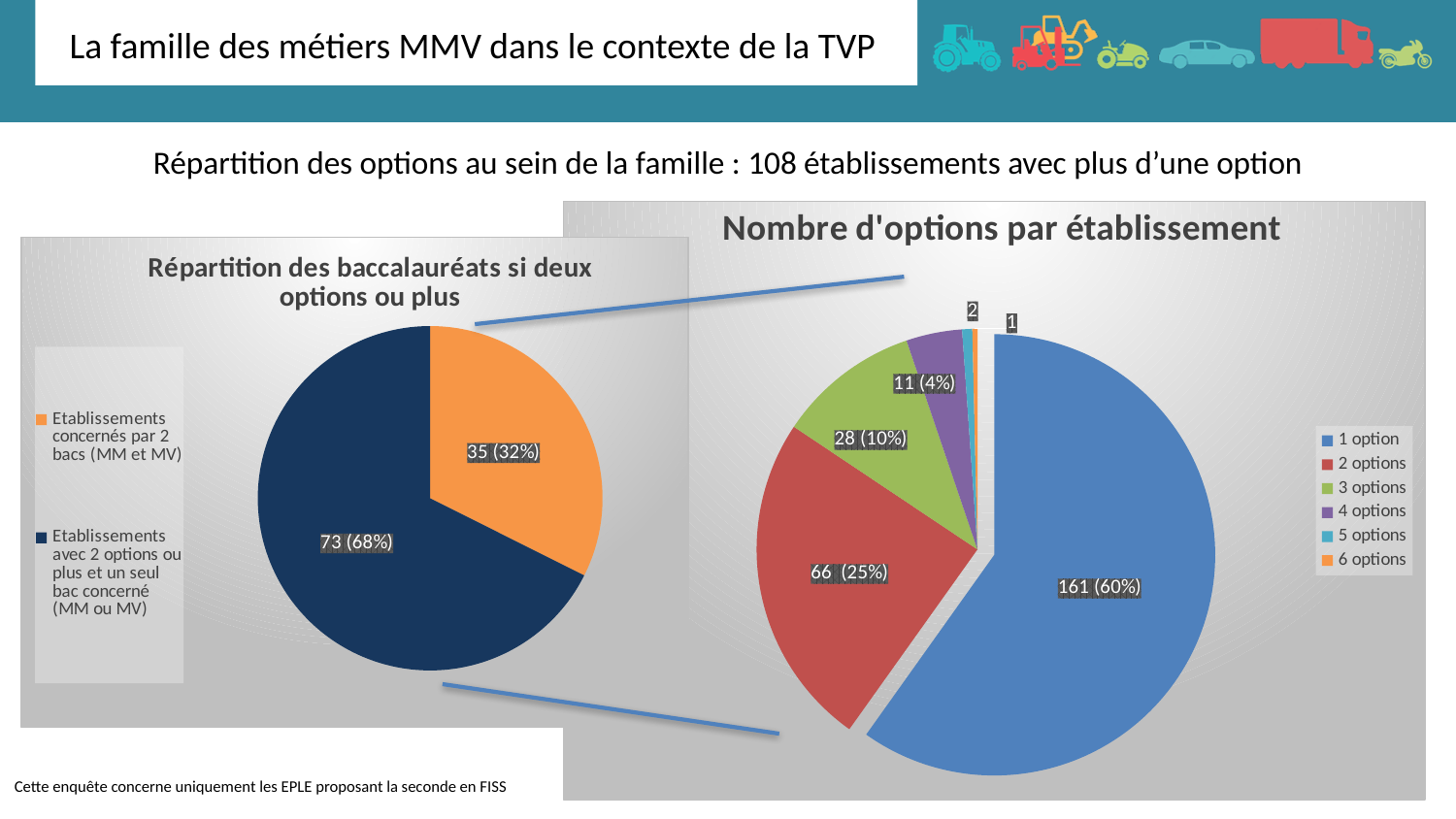
In the chart "Répartition des baccalauréats si deux options ou plus", what colour is the slice for "Etablissements concernés par 2 bacs (MM et MV)"? orange In the chart "Répartition des baccalauréats si deux options ou plus", what is the value for "Etablissements concernés par 2 bacs (MM et MV)"? 35 (32%) In the chart "Nombre d'options par établissement", which category has the smallest slice? 6 options In the chart "Répartition des baccalauréats si deux options ou plus", what is the difference between the two slice counts? 38 What kind of chart is "Nombre d'options par établissement"? pie chart In the chart "Nombre d'options par établissement", what is the difference between the counts for 2 options and 3 options? 38 In the chart "Nombre d'options par établissement", what is the value for 3 options? 28 (10%) In the chart "Nombre d'options par établissement", what is the value for 1 option? 161 (60%) In the chart "Nombre d'options par établissement", which category has the largest slice? 1 option In the chart "Répartition des baccalauréats si deux options ou plus", which of the two categories is larger? Etablissements avec 2 options ou plus et un seul bac concerné (MM ou MV) In the chart "Nombre d'options par établissement", what share of the pie does 2 options represent? 25% In the chart "Nombre d'options par établissement", how many entries does the legend list? 6